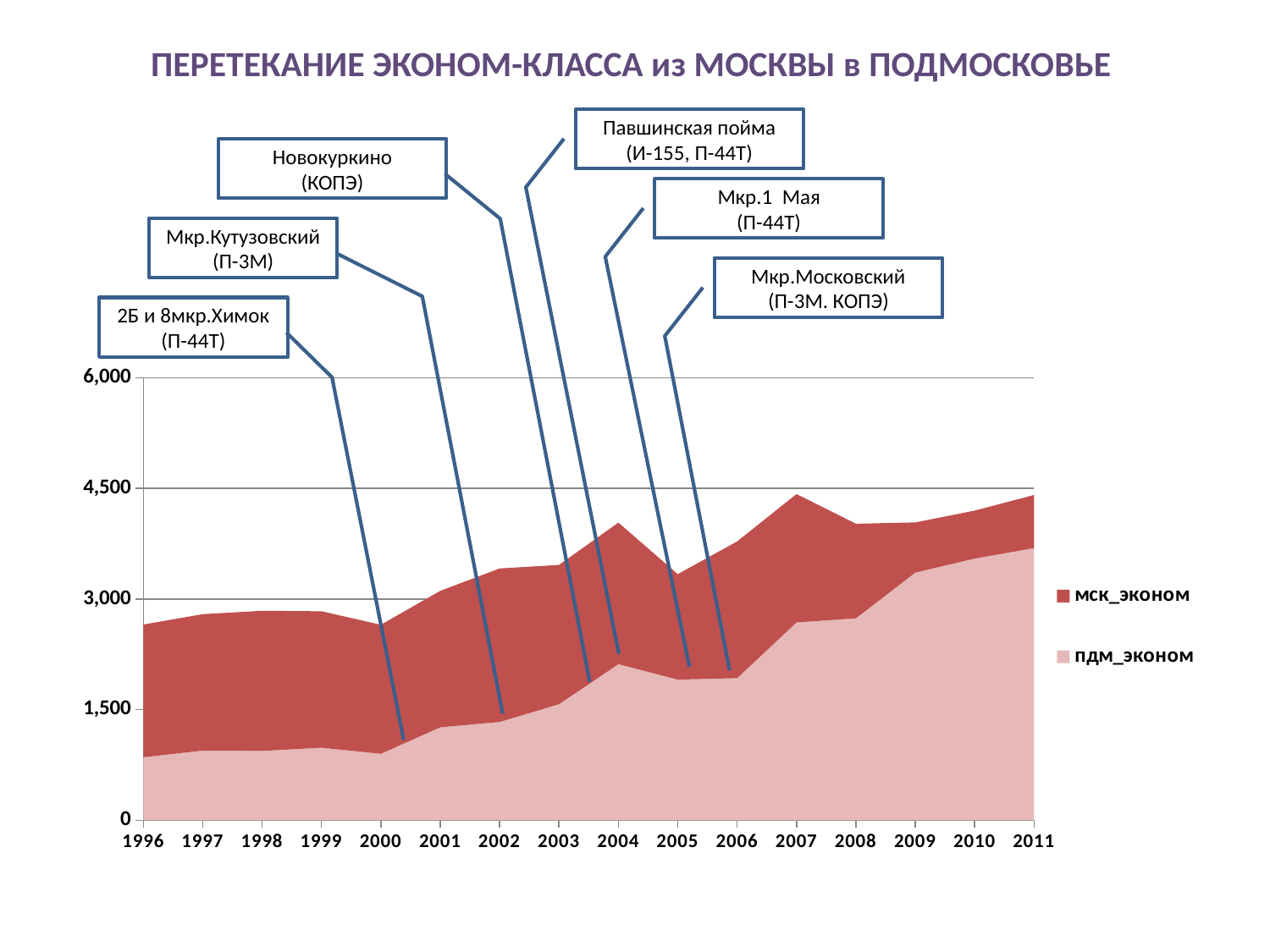
Which series has the larger value in 2011, мск_эконом or пдм_эконом? пдм_эконом Is the value for пдм_эконом in 2000 greater or less than 1,500? less Is the value for пдм_эконом in 2011 greater or less than 3,000? greater Does the пдм_эконом series rise or fall from 2006 to 2011? rises Is the stacked total for 2004 greater or less than 3,000? greater What is the title of the chart? ПЕРЕТЕКАНИЕ ЭКОНОМ-КЛАССА из МОСКВЫ в ПОДМОСКОВЬЕ Which series has the larger value in 1996, мск_эконом or пдм_эконом? мск_эконом How many years are shown along the x axis? 16 What kind of chart is shown on the slide? Stacked area chart What are the two series named in the legend? мск_эконом and пдм_эконом How many series does the legend list? 2